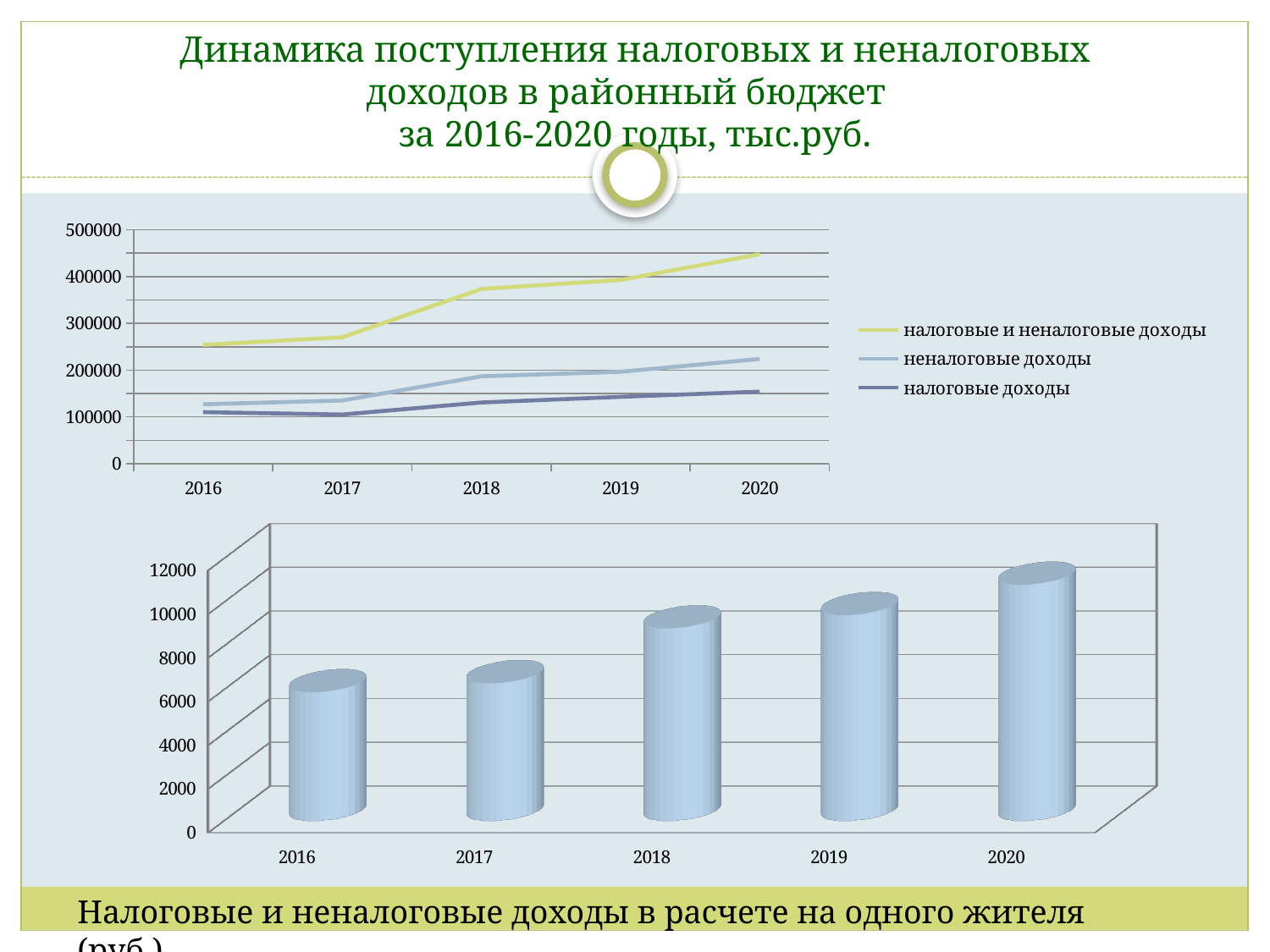
What kind of chart is the bottom chart on the slide? bar chart In the top chart, is the value of налоговые и неналоговые доходы for 2020 greater or less than 400000? greater In the top chart, which series has the highest values across all years? налоговые и неналоговые доходы In the top chart, does the line for налоговые и неналоговые доходы rise or fall from 2016 to 2020? rises In the bottom chart, is the value for 2020 greater or less than 10000? greater What kind of chart is the top chart on the slide? line chart In the bottom chart, which year has the highest bar? 2020 How many series does the legend of the top chart list? 3 In the bottom chart, which year has the lowest bar? 2016 In the top chart, is the value of неналоговые доходы for 2020 greater or less than 200000? greater How many years are shown on the x axis of the bottom chart? 5